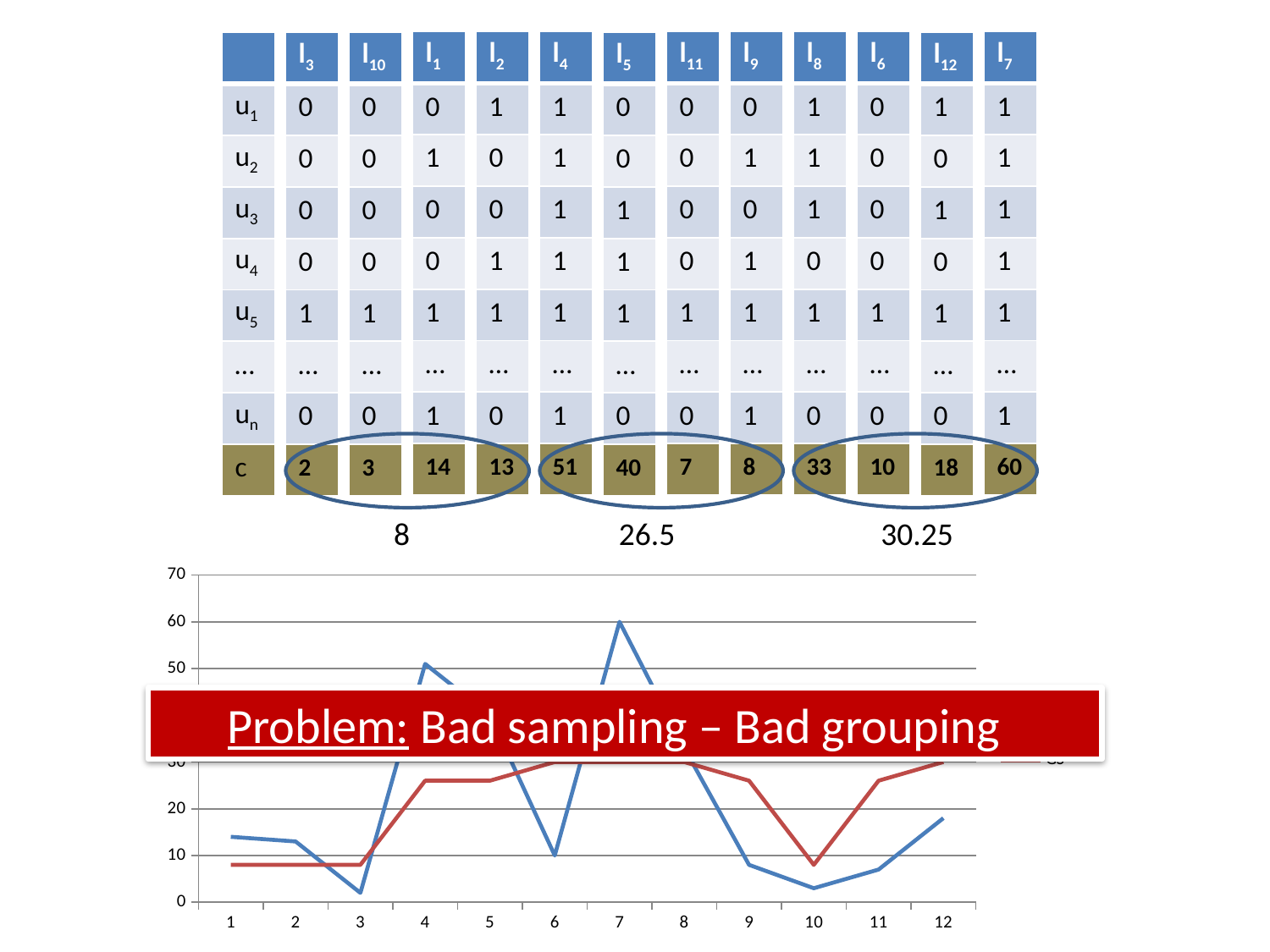
Is the value of the red line at x = 4 greater or less than 20? greater What is the highest value shown on the y axis of the line chart? 70 What kind of chart is shown at the bottom of the slide? line chart At x = 1, which line is higher, the blue line or the red line? blue line What is the value of the blue line at x = 7? 60 How many lines are plotted on the line chart? 2 At x = 10, which line is higher, the blue line or the red line? red line Is the value of the blue line at x = 10 greater or less than 10? less Does the blue line rise or fall from x = 1 to x = 3? fall At which x-axis value does the blue line reach its highest point? 7 How many points are labelled along the x axis of the line chart? 12